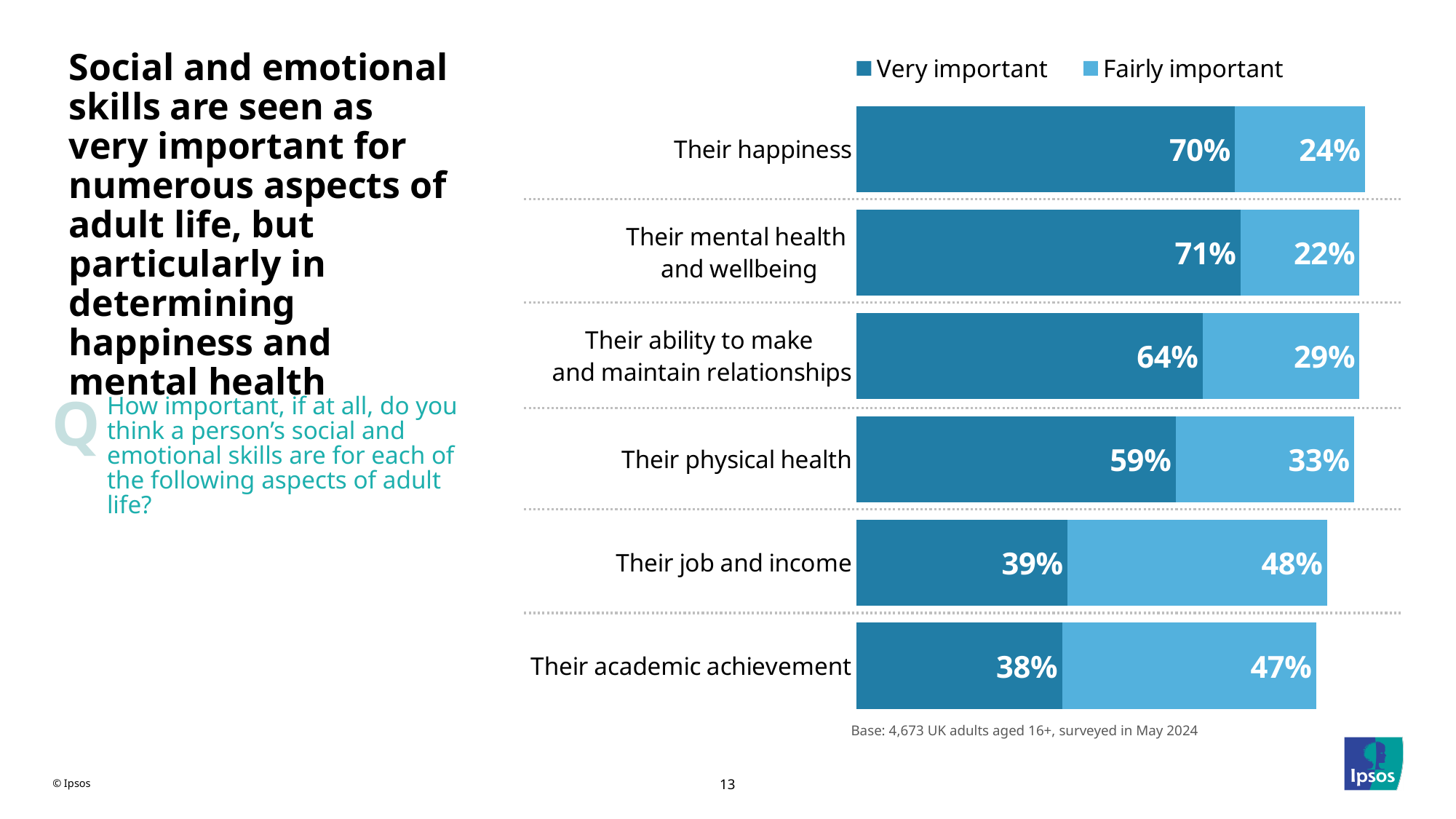
What kind of chart is shown on the slide? Stacked bar chart How many aspects of adult life are shown in the chart? 6 What is the 'Very important' value for their physical health? 59% What is the difference between the 'Very important' values for their happiness and their job and income? 31 percentage points What is the combined total of 'Very important' and 'Fairly important' for their happiness? 94% What percentage said social and emotional skills are fairly important for their job and income? 48% Which aspect has the lowest 'Very important' percentage? Their academic achievement How many series does the legend list? 2 What is the combined total of 'Very important' and 'Fairly important' for their academic achievement? 85% Which aspect has the highest 'Very important' percentage? Their mental health and wellbeing Which is larger: the 'Fairly important' value for their physical health or for their ability to make and maintain relationships? Their physical health What percentage of respondents said social and emotional skills are very important for their happiness? 70%